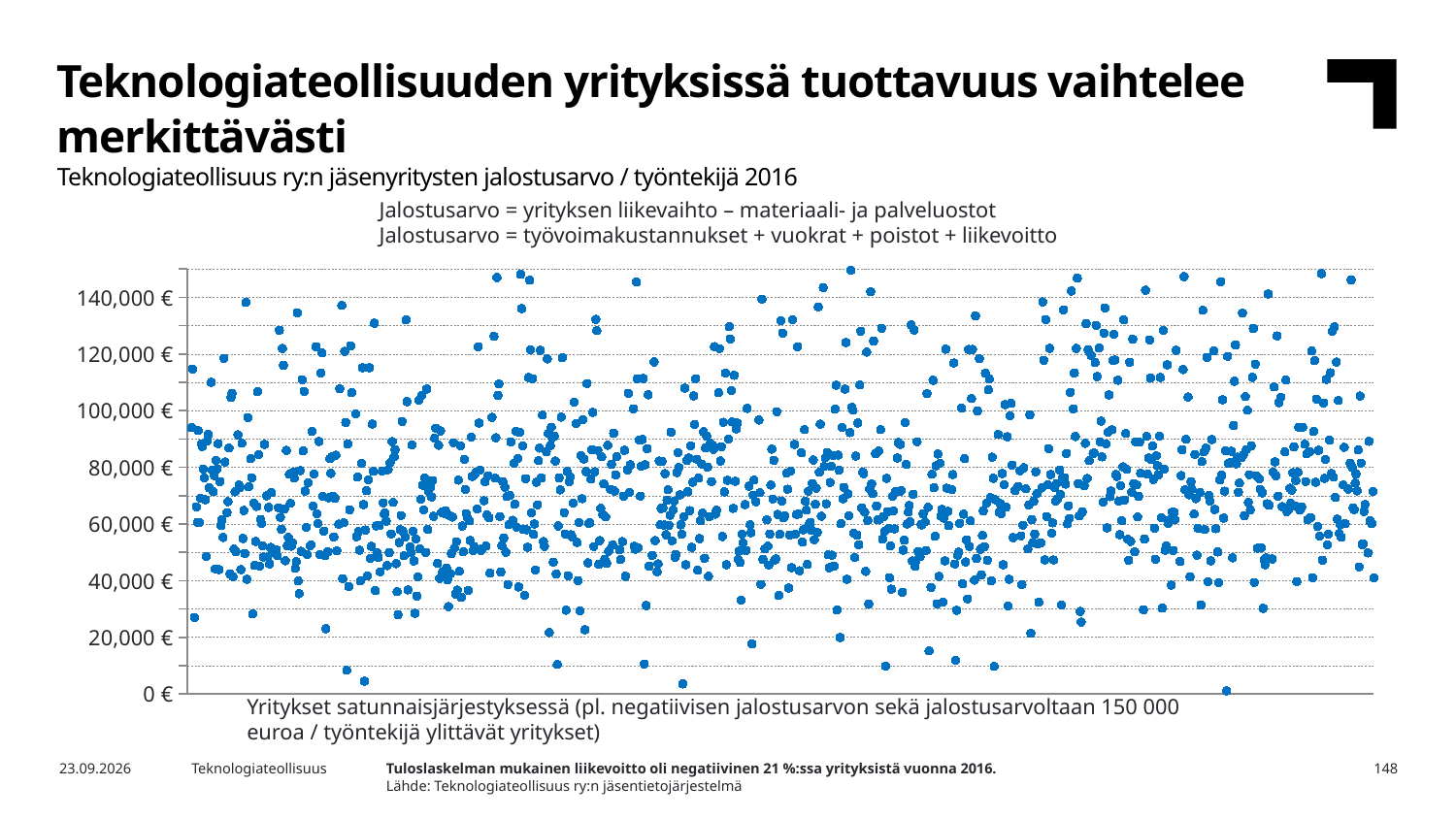
How many tick labels are shown on the vertical axis of the chart? 8 Which year's data does the chart show? 2016 What is the highest value labelled on the vertical axis of the chart? 140,000 € Do the plotted values show a clear rising or falling trend along the horizontal axis? no According to the note below the chart, companies above what value added per employee are excluded? 150 000 euroa / työntekijä What is the interval between consecutive tick labels on the vertical axis? 20,000 € What kind of chart is shown on the slide? scatter chart What is the lowest value labelled on the vertical axis of the chart? 0 €